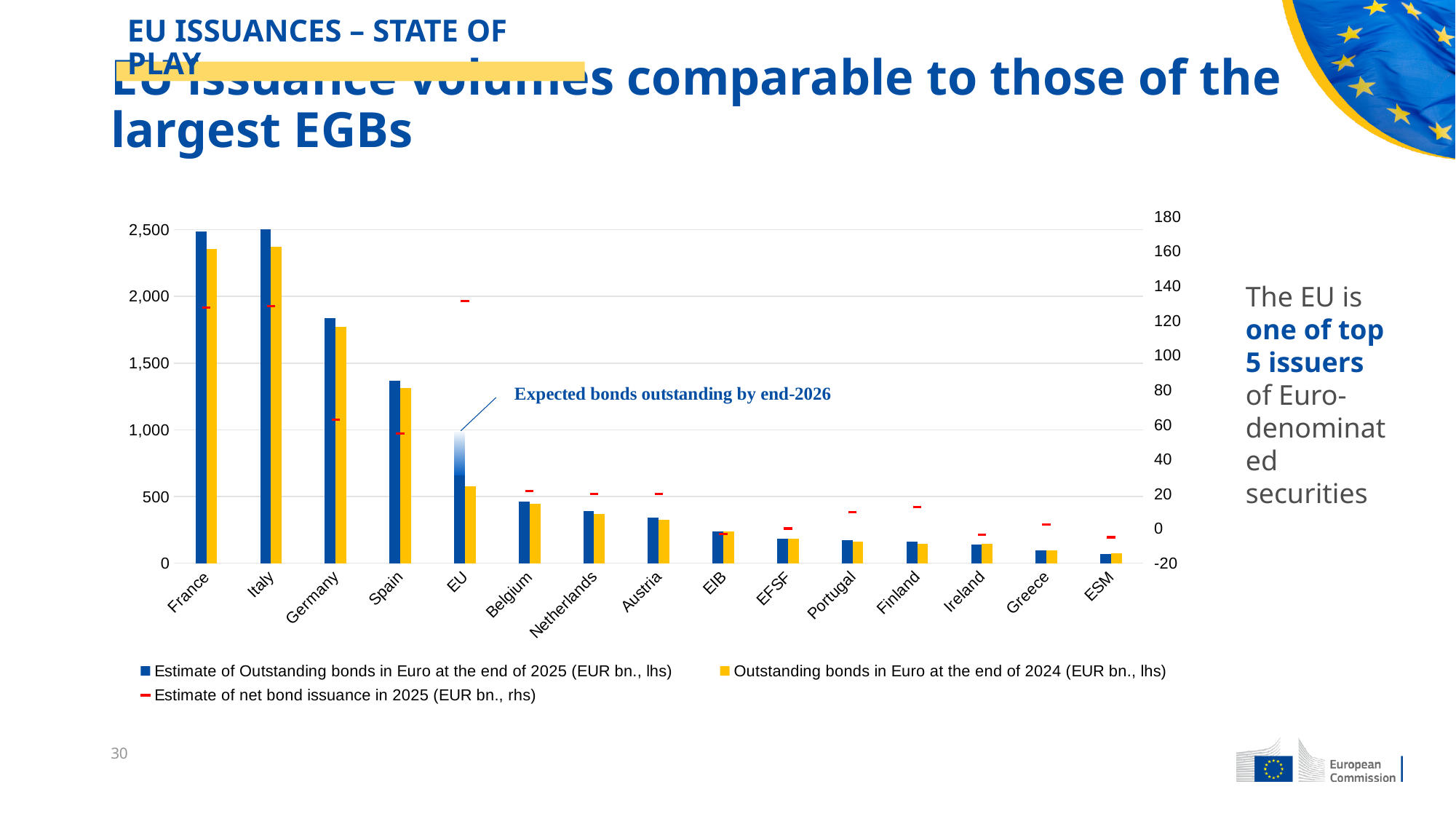
How many issuers are shown along the x axis of the chart? 15 Which issuer has the highest estimate of net bond issuance in 2025 (red marker)? EU What kind of chart is shown on the slide? bar chart Is the estimate of outstanding bonds at the end of 2025 for France greater or less than 2,000? greater Which issuer has the lowest estimate of outstanding bonds at the end of 2025? ESM Is the value of outstanding bonds at the end of 2024 for the EU greater or less than 500? greater Which bar does the annotation 'Expected bonds outstanding by end-2026' point to? EU Is the estimate of outstanding bonds at the end of 2025 for Spain greater or less than 1,500? less How many series does the chart legend list? 3 Which has the larger estimate of outstanding bonds at the end of 2025, Germany or Spain? Germany